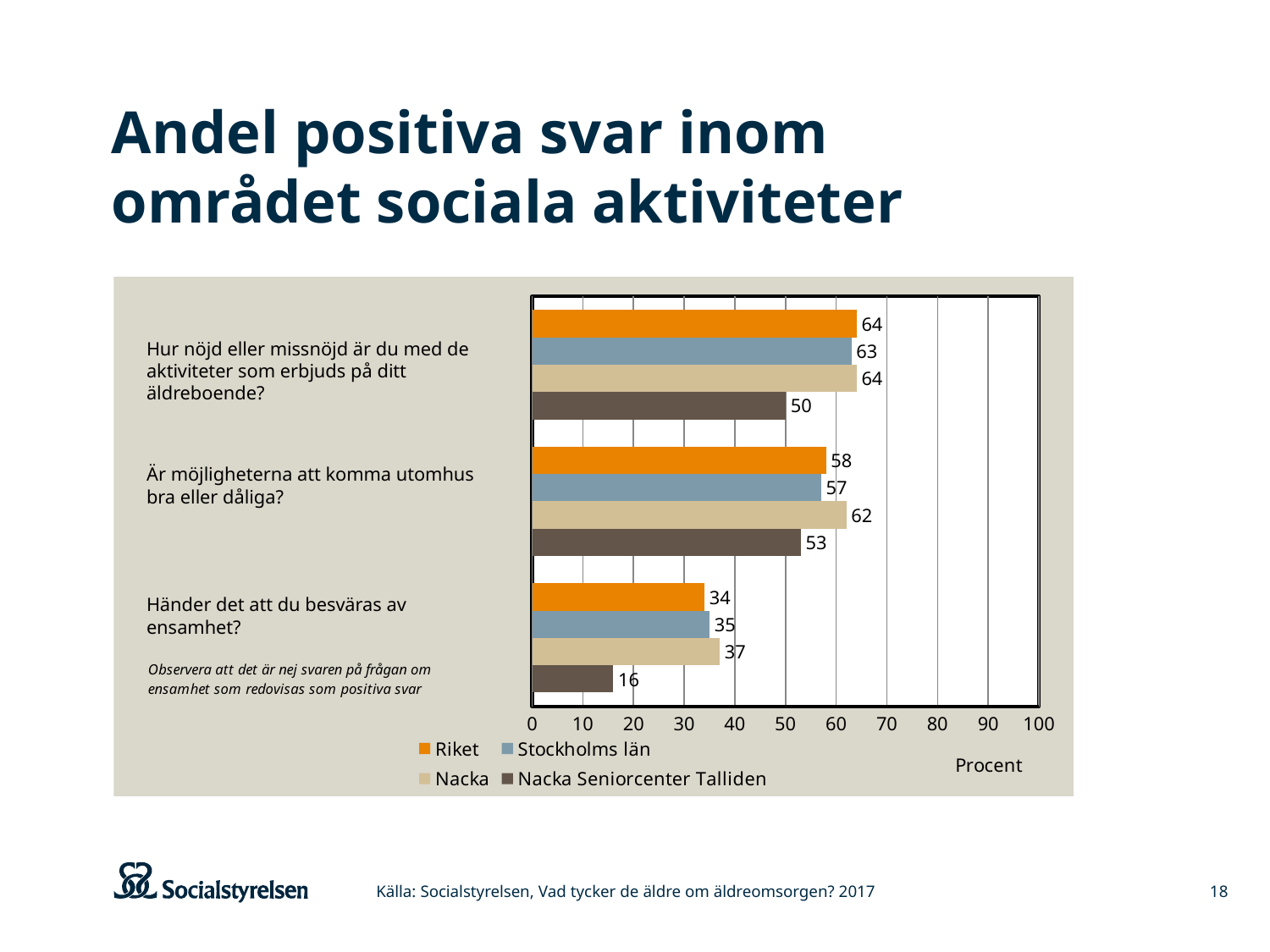
What kind of chart is shown on the slide? Bar chart What is the value for Stockholms län on the question "Händer det att du besväras av ensamhet?"? 35 Which series has the highest value on the question "Är möjligheterna att komma utomhus bra eller dåliga?"? Nacka What is the value for Nacka on the question "Är möjligheterna att komma utomhus bra eller dåliga?"? 62 What is the difference between Nacka and Nacka Seniorcenter Talliden on the question "Händer det att du besväras av ensamhet?"? 21 Which series has the lowest value on the question "Hur nöjd eller missnöjd är du med de aktiviteter som erbjuds på ditt äldreboende?"? Nacka Seniorcenter Talliden What unit is shown on the horizontal axis of the chart? Procent How many series does the legend list? 4 Which is larger on the question "Är möjligheterna att komma utomhus bra eller dåliga?": Riket or Nacka Seniorcenter Talliden? Riket What is the value for Nacka Seniorcenter Talliden on the question "Händer det att du besväras av ensamhet?"? 16 Is the value for Nacka Seniorcenter Talliden on the question "Händer det att du besväras av ensamhet?" greater or less than 20? less What is the value for Riket on the question "Hur nöjd eller missnöjd är du med de aktiviteter som erbjuds på ditt äldreboende?"? 64